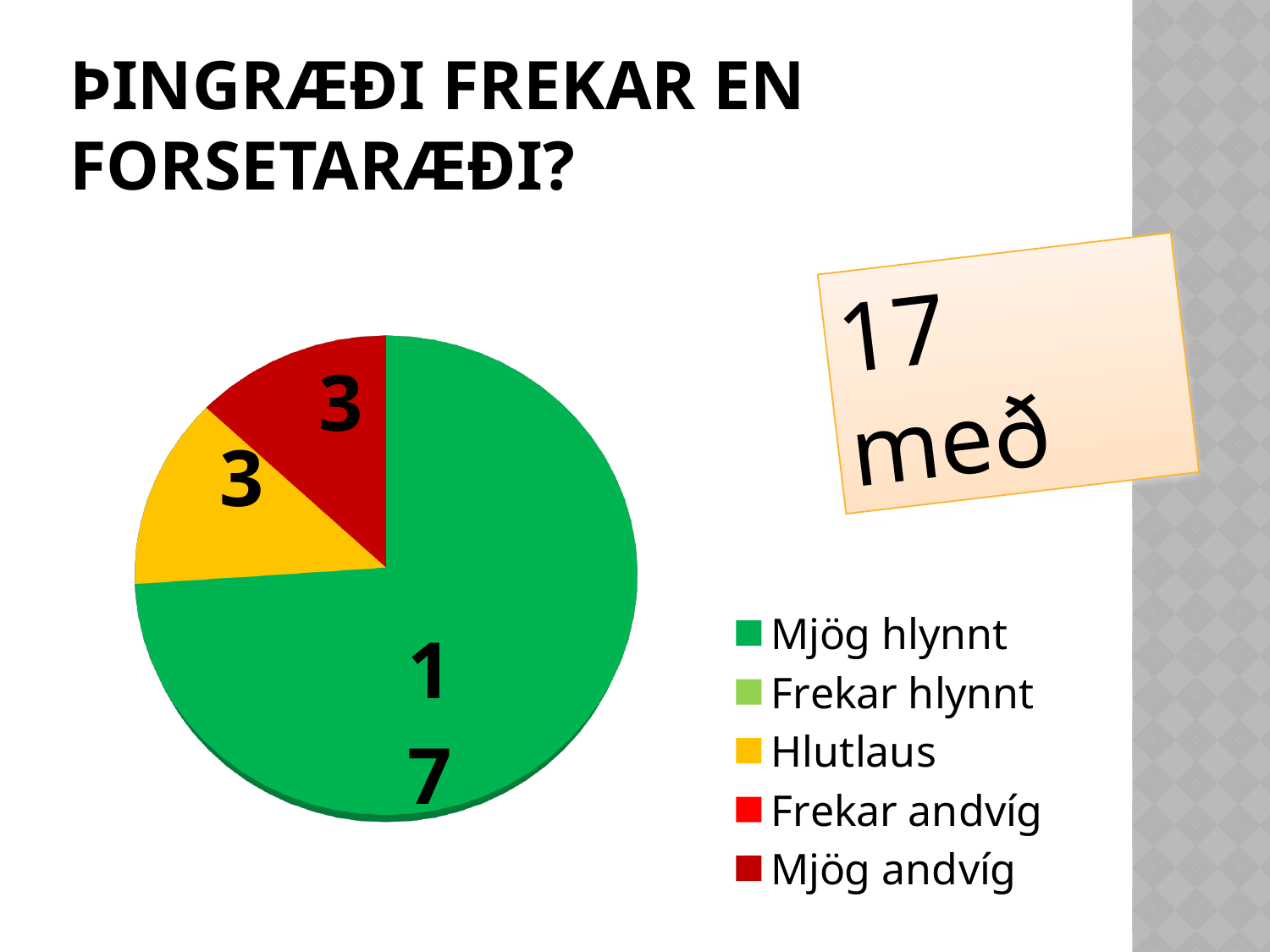
What value is shown for the Mjög andvíg slice of the pie chart? 3 What colour is the Hlutlaus slice in the pie chart? Yellow What kind of chart is shown on the slide? Pie chart Which category has the largest slice in the pie chart? Mjög hlynnt Which is larger in the pie chart, Mjög hlynnt or Mjög andvíg? Mjög hlynnt How many entries does the legend of the pie chart list? 5 How many slices with data labels are visible in the pie chart? 3 What value is shown for the Hlutlaus slice of the pie chart? 3 What value is shown for the Mjög hlynnt slice of the pie chart? 17 What is the difference between the Mjög hlynnt value and the Hlutlaus value in the pie chart? 14 What is the title of the slide containing the pie chart? Þingræði frekar en forsetaræði? What is the sum of the three labelled slices in the pie chart? 23